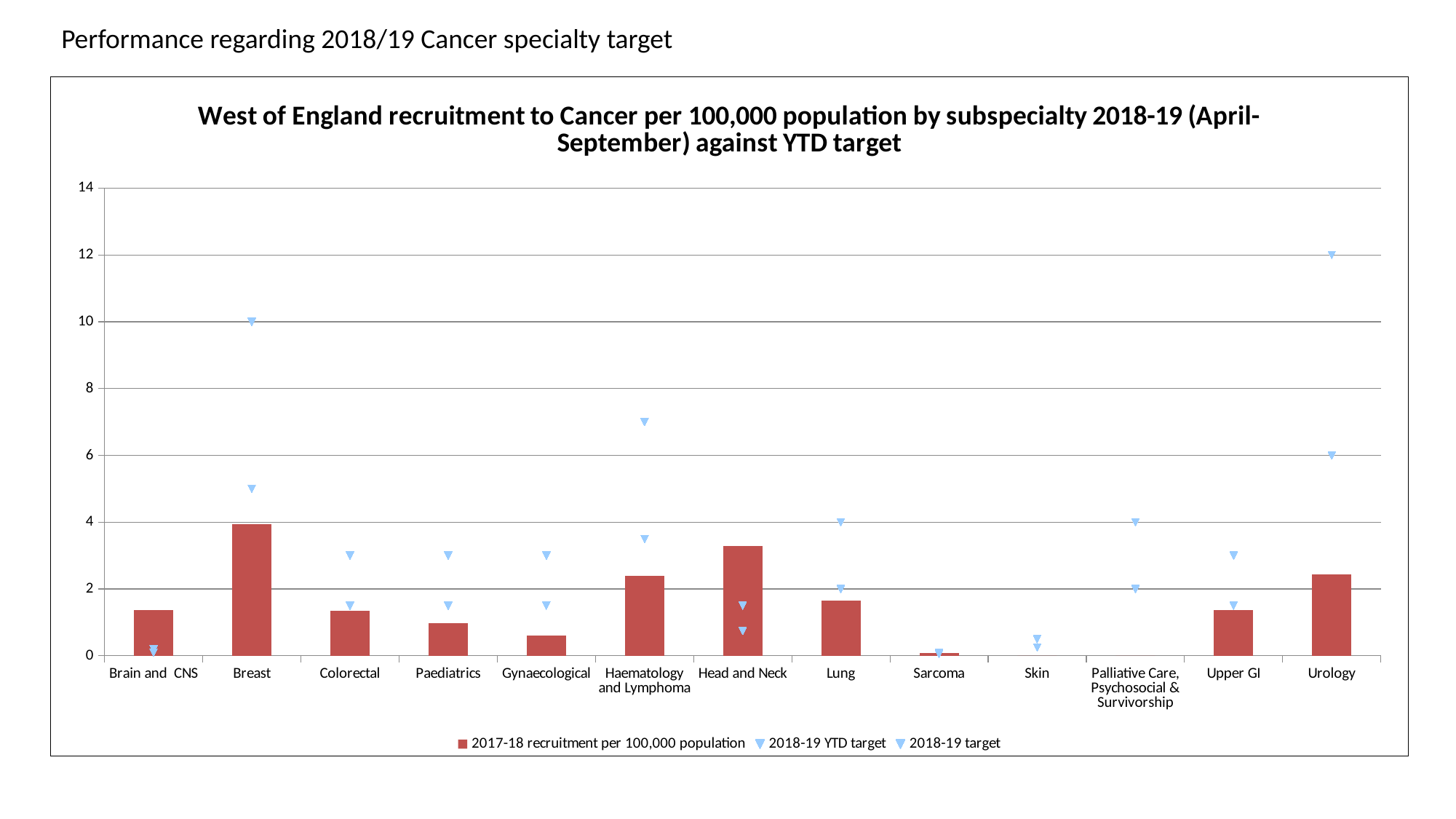
What is the 2018-19 target value for Urology? 12 How many subspecialty categories are shown on the x axis? 13 Which subspecialty has the highest 2017-18 recruitment per 100,000 population bar? Breast Which has the larger 2017-18 recruitment bar, Breast or Head and Neck? Breast What is the 2018-19 target value for Breast? 10 Which subspecialty has the highest 2018-19 target marker? Urology Is the 2017-18 recruitment bar for Breast greater or less than 2? greater What kind of chart is shown on the slide? bar chart What is the title of the chart? West of England recruitment to Cancer per 100,000 population by subspecialty 2018-19 (April-September) against YTD target What is the 2018-19 YTD target value for Urology? 6 How many series does the legend list? 3 Is the 2017-18 recruitment bar for Gynaecological greater or less than 2? less